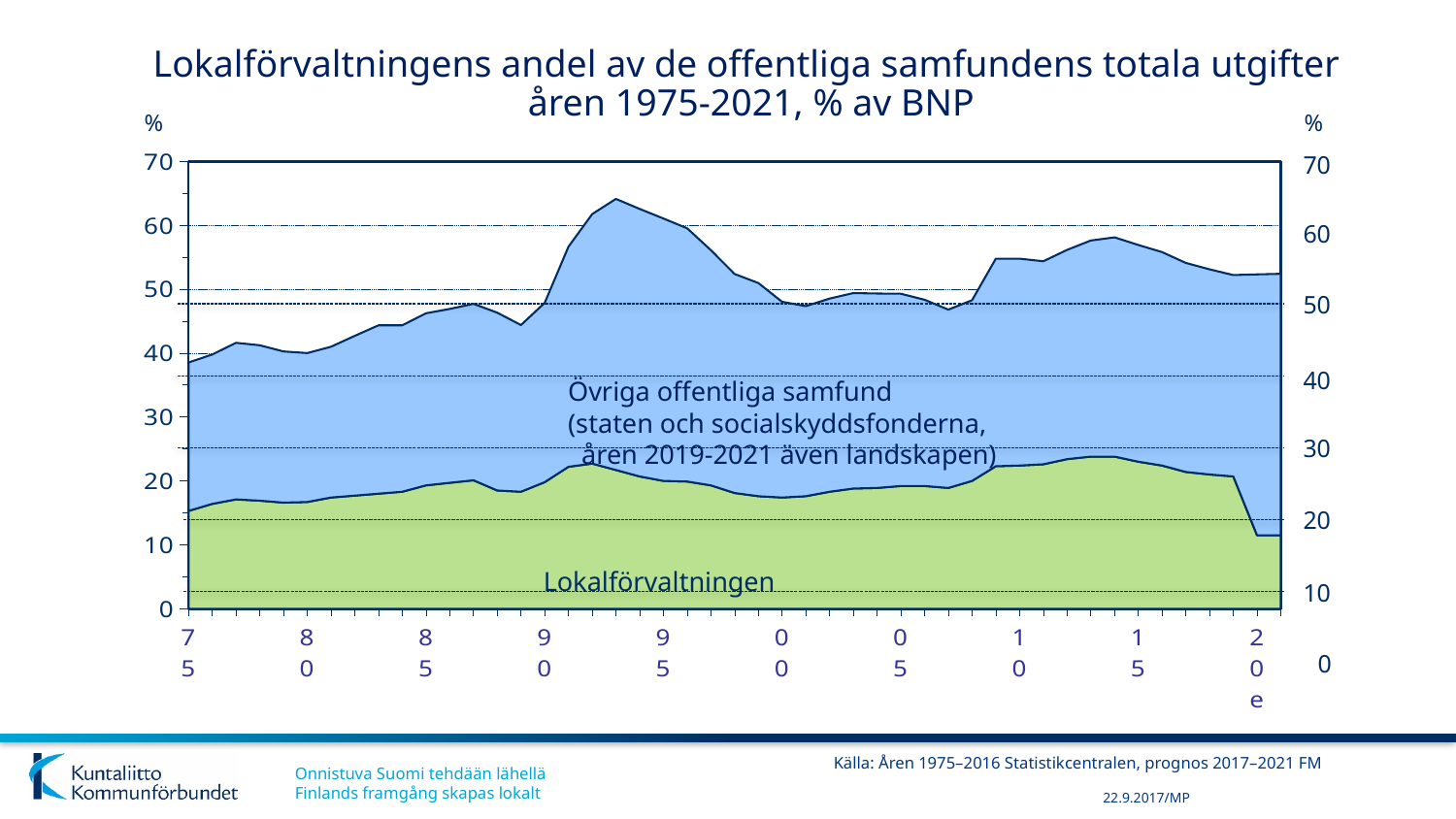
How many series are plotted in the chart? 2 Which series is shown in green at the bottom of the chart? Lokalförvaltningen Is the value for Lokalförvaltningen around 2015 greater or less than 20? greater Is the value for Lokalförvaltningen at the end of the series (2020e) greater or less than 20? less Is the total of the stacked areas in 1975 greater or less than 40? less What is the unit shown on the vertical axes of the chart? % What kind of chart is shown on the slide? Area chart Does the value for Lokalförvaltningen rise or fall between 1975 and 1990? rise Does the total of the stacked areas rise or fall between the early 1990s peak and 2000? fall